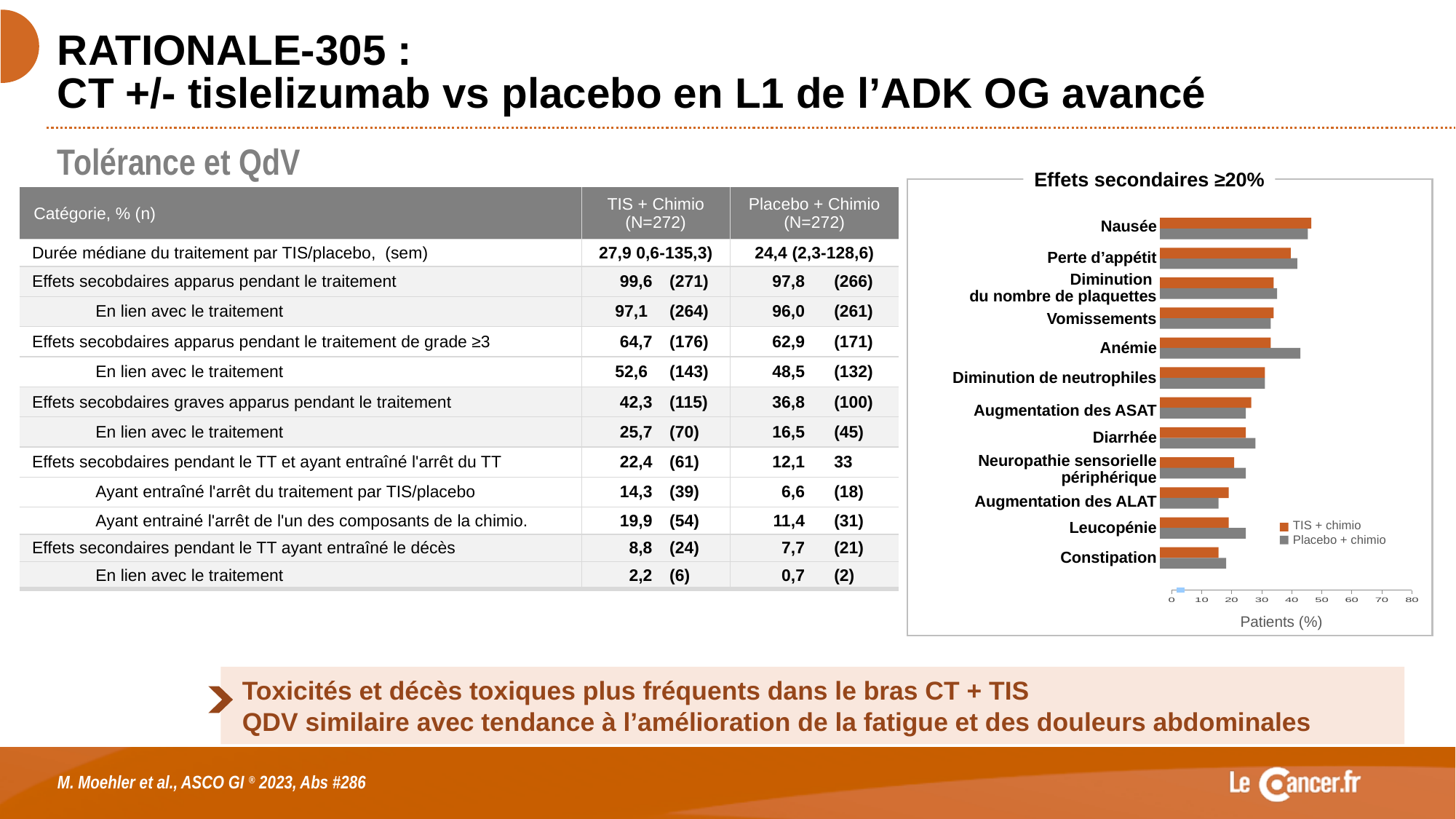
How many side-effect categories are plotted in the chart? 12 What is the title of the chart on the right of the slide? Effets secondaires ≥20% Is the Placebo + chimio value for Anémie greater or less than 30? greater What is the label of the horizontal axis of the chart? Patients (%) How many series does the chart legend list? 2 Which side effect has the highest value for TIS + chimio in the chart? Nausée For Leucopénie, which series has the larger value, TIS + chimio or Placebo + chimio? Placebo + chimio Is the TIS + chimio value for Nausée greater or less than 40? greater What kind of chart is shown on the slide? bar chart For Anémie, which series has the larger value, TIS + chimio or Placebo + chimio? Placebo + chimio Which side effect has the lowest value for TIS + chimio in the chart? Constipation